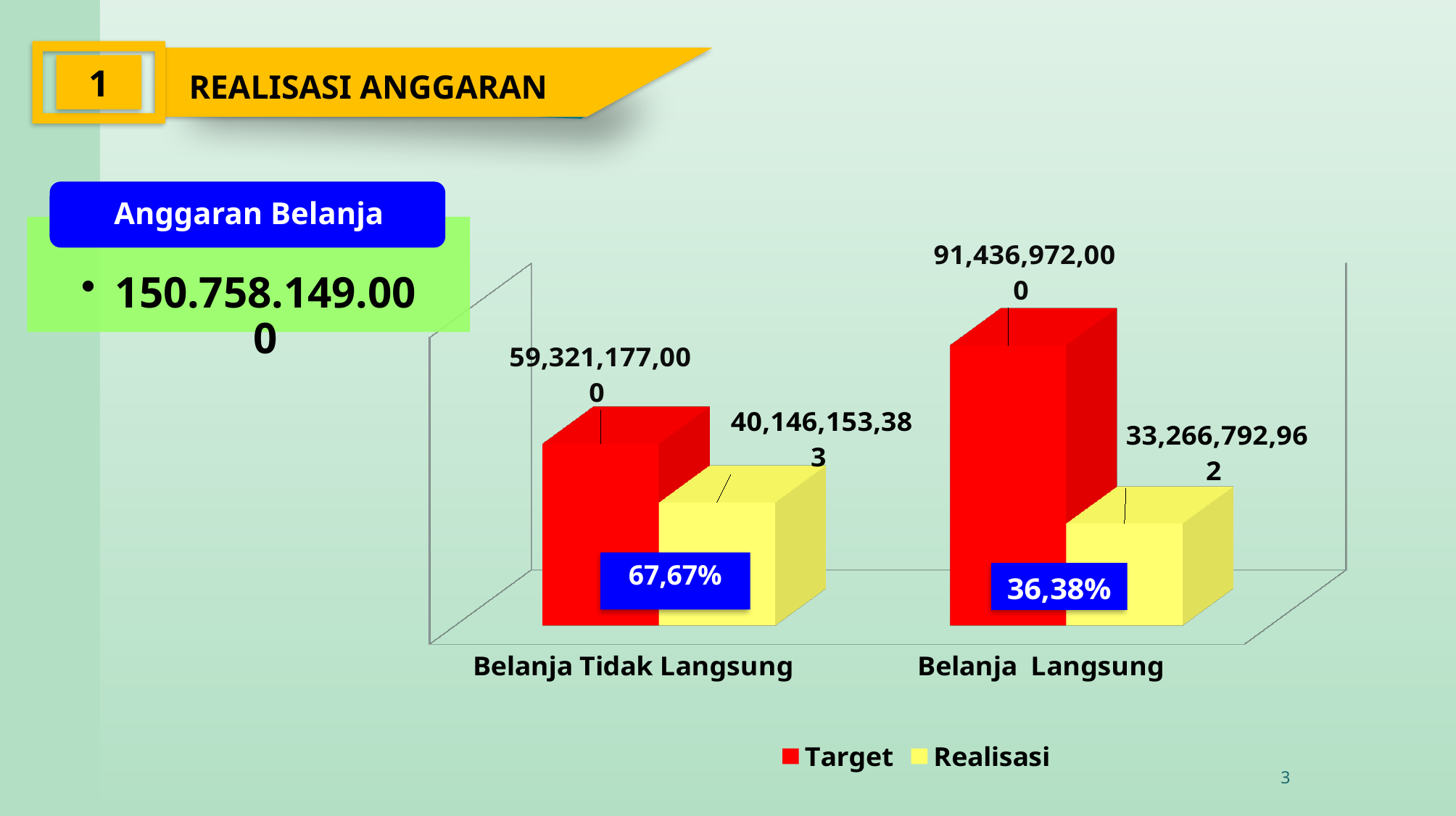
Which category has the highest Target value? Belanja Langsung What is the difference between Target and Realisasi for Belanja Tidak Langsung? 19,175,023,617 How many categories are shown on the x axis of the chart? 2 How many series does the chart legend list? 2 What kind of chart is shown on the slide? Bar chart Which category has the lowest Realisasi value? Belanja Langsung What is the Realisasi value for Belanja Langsung? 33,266,792,962 What is the difference between Target and Realisasi for Belanja Langsung? 58,170,179,038 What is the Realisasi value for Belanja Tidak Langsung? 40,146,153,383 What is the Target value for Belanja Langsung? 91,436,972,000 Which is larger: the Realisasi for Belanja Tidak Langsung or the Realisasi for Belanja Langsung? Belanja Tidak Langsung What is the Target value for Belanja Tidak Langsung? 59,321,177,000